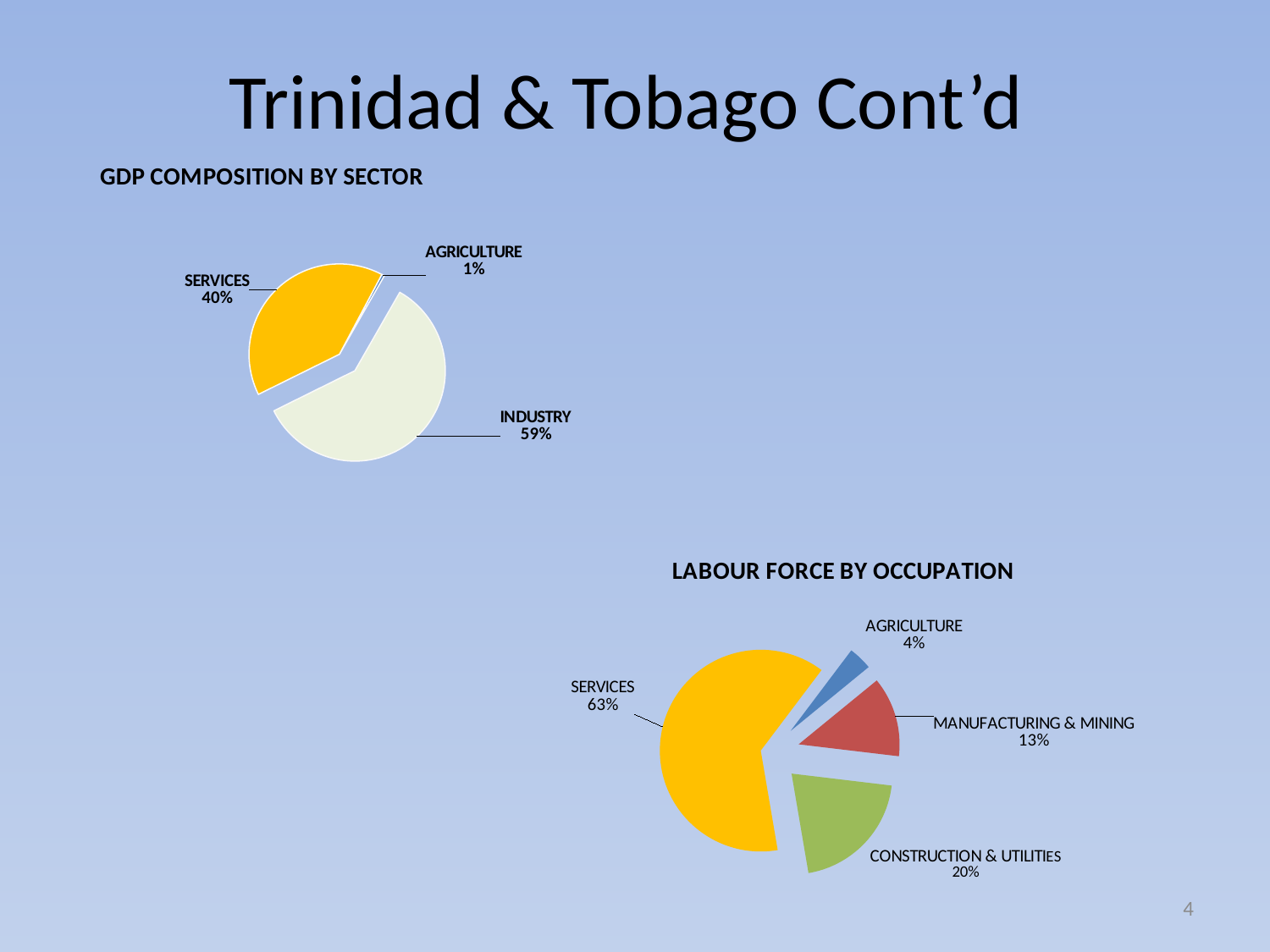
How many slices does the GDP COMPOSITION BY SECTOR chart have? 3 In the GDP COMPOSITION BY SECTOR chart, what is the difference between the INDUSTRY and SERVICES shares? 19% In the LABOUR FORCE BY OCCUPATION chart, what share does MANUFACTURING & MINING have? 13% In the GDP COMPOSITION BY SECTOR chart, what share does INDUSTRY have? 59% In the LABOUR FORCE BY OCCUPATION chart, what share does CONSTRUCTION & UTILITIES have? 20% In the GDP COMPOSITION BY SECTOR chart, what share does SERVICES have? 40% In the GDP COMPOSITION BY SECTOR chart, which sector has the largest share? INDUSTRY In the GDP COMPOSITION BY SECTOR chart, which sector has the smallest share? AGRICULTURE What kind of chart is the LABOUR FORCE BY OCCUPATION chart? Pie chart In the LABOUR FORCE BY OCCUPATION chart, which occupation has the largest share? SERVICES In the LABOUR FORCE BY OCCUPATION chart, which is larger, CONSTRUCTION & UTILITIES or MANUFACTURING & MINING? CONSTRUCTION & UTILITIES How many slices does the LABOUR FORCE BY OCCUPATION chart have? 4